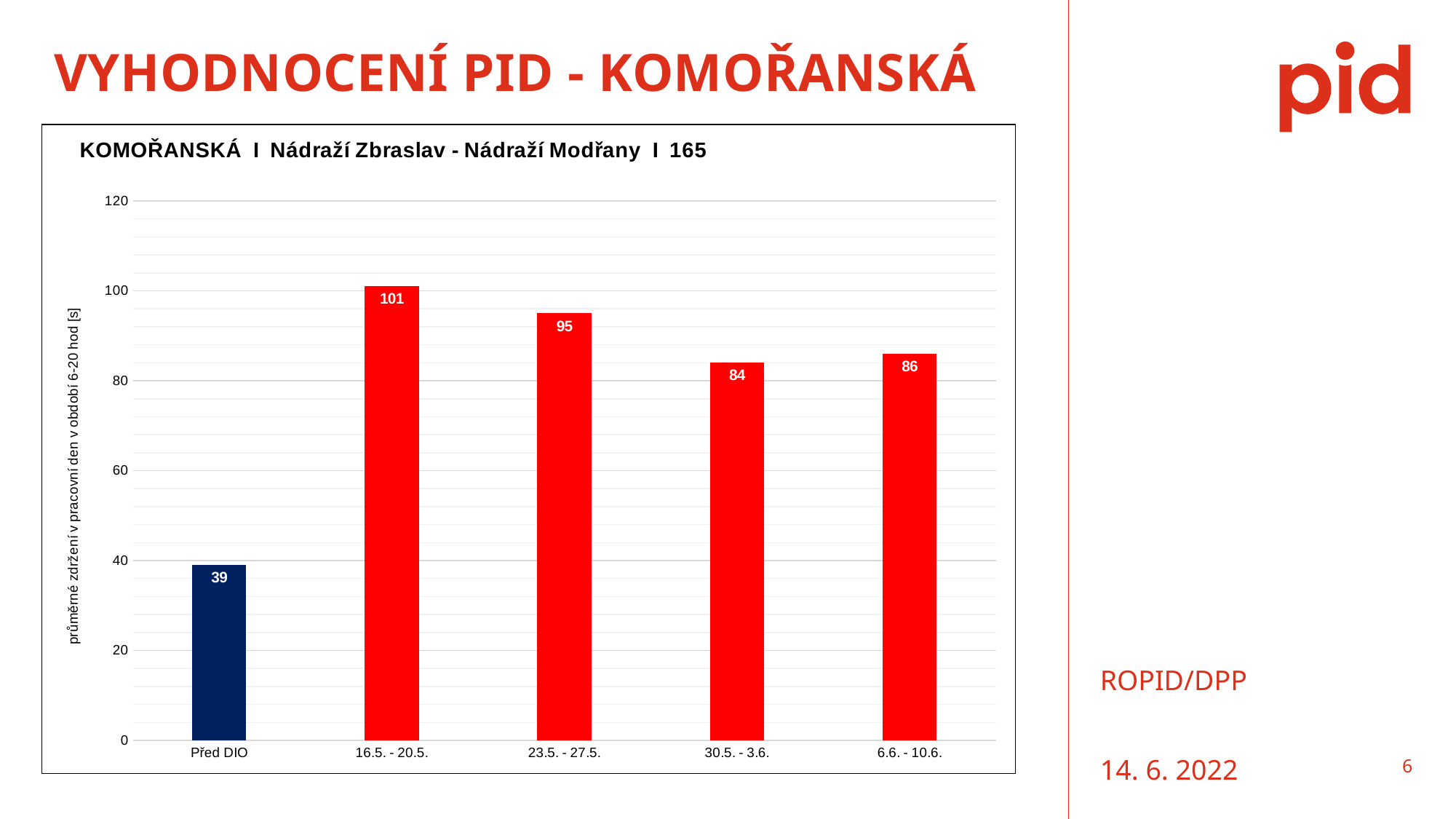
What is the value for '30.5. - 3.6.'? 84 Which is larger, the value for '30.5. - 3.6.' or the value for '6.6. - 10.6.'? 6.6. - 10.6. What is the difference between the values for '16.5. - 20.5.' and 'Před DIO'? 62 How many categories are shown on the x axis? 5 What is the difference between the values for '23.5. - 27.5.' and '6.6. - 10.6.'? 9 Which category has the highest value? 16.5. - 20.5. What is the title of the chart? KOMOŘANSKÁ I Nádraží Zbraslav - Nádraží Modřany I 165 What is the value for 'Před DIO'? 39 What kind of chart is shown on the slide? bar chart Which category has the lowest value? Před DIO Is the value for '23.5. - 27.5.' greater or less than 100? less What is the value for '16.5. - 20.5.'? 101